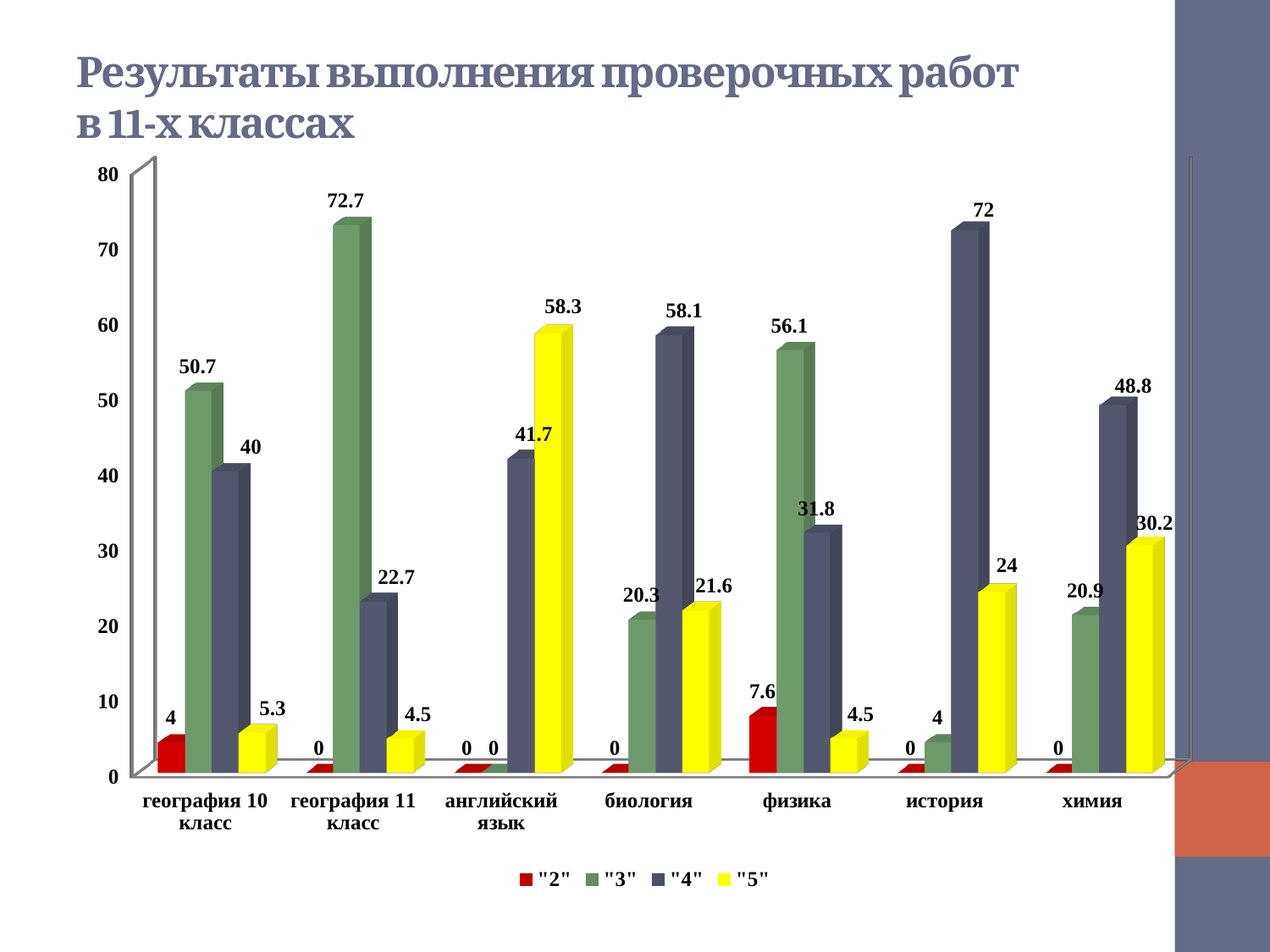
How many categories are shown on the x axis? 7 What kind of chart is shown on the slide? Bar chart What is the value of series "4" for история? 72 What is the value of series "2" for физика? 7.6 Which category has the highest value for series "4"? история What is the difference between the "4" and "5" values for химия? 18.6 What is the value of series "3" for география 11 класс? 72.7 Which category has the lowest value for series "5"? география 11 класс and физика (both 4.5) Which is larger for биология: the value for series "3" or series "5"? "5" How many series does the legend list? 4 What colour represents series "5" in the legend? Yellow What is the value of series "5" for английский язык? 58.3